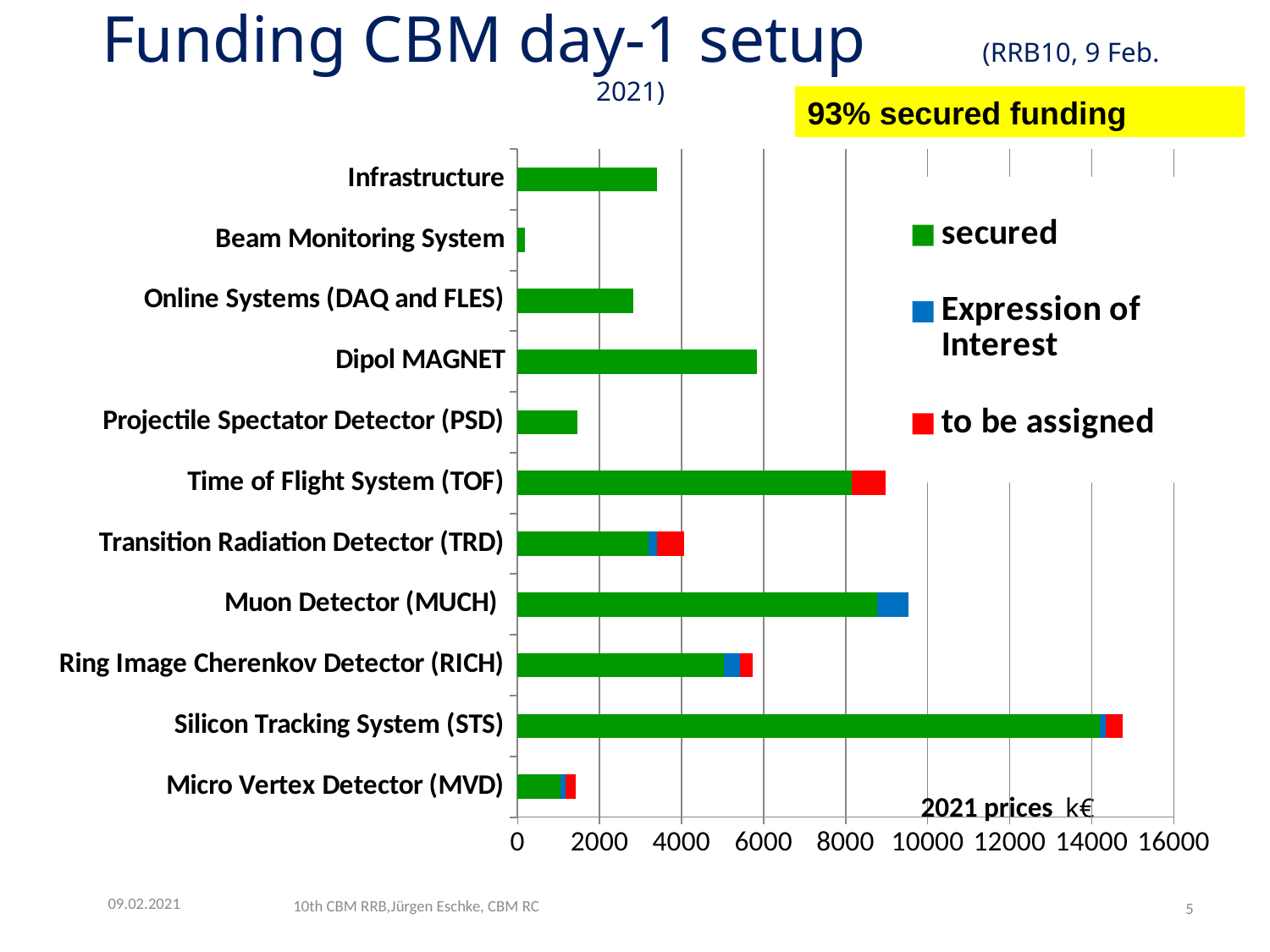
How many categories (subsystems) are listed on the chart? 11 Which subsystem has the largest total bar? Silicon Tracking System (STS) How many series does the chart legend list? 3 Is the total value for Silicon Tracking System (STS) greater or less than 14000? greater Which colour represents the 'secured' series in the legend? green Is the total value for Projectile Spectator Detector (PSD) greater or less than 2000? less Is the total value for Infrastructure greater or less than 4000? less What kind of chart is shown on the slide? bar chart What unit is given for the x axis of the chart? k€ (2021 prices) Which has the larger total bar, Dipol MAGNET or Infrastructure? Dipol MAGNET Which subsystem has the smallest total bar? Beam Monitoring System